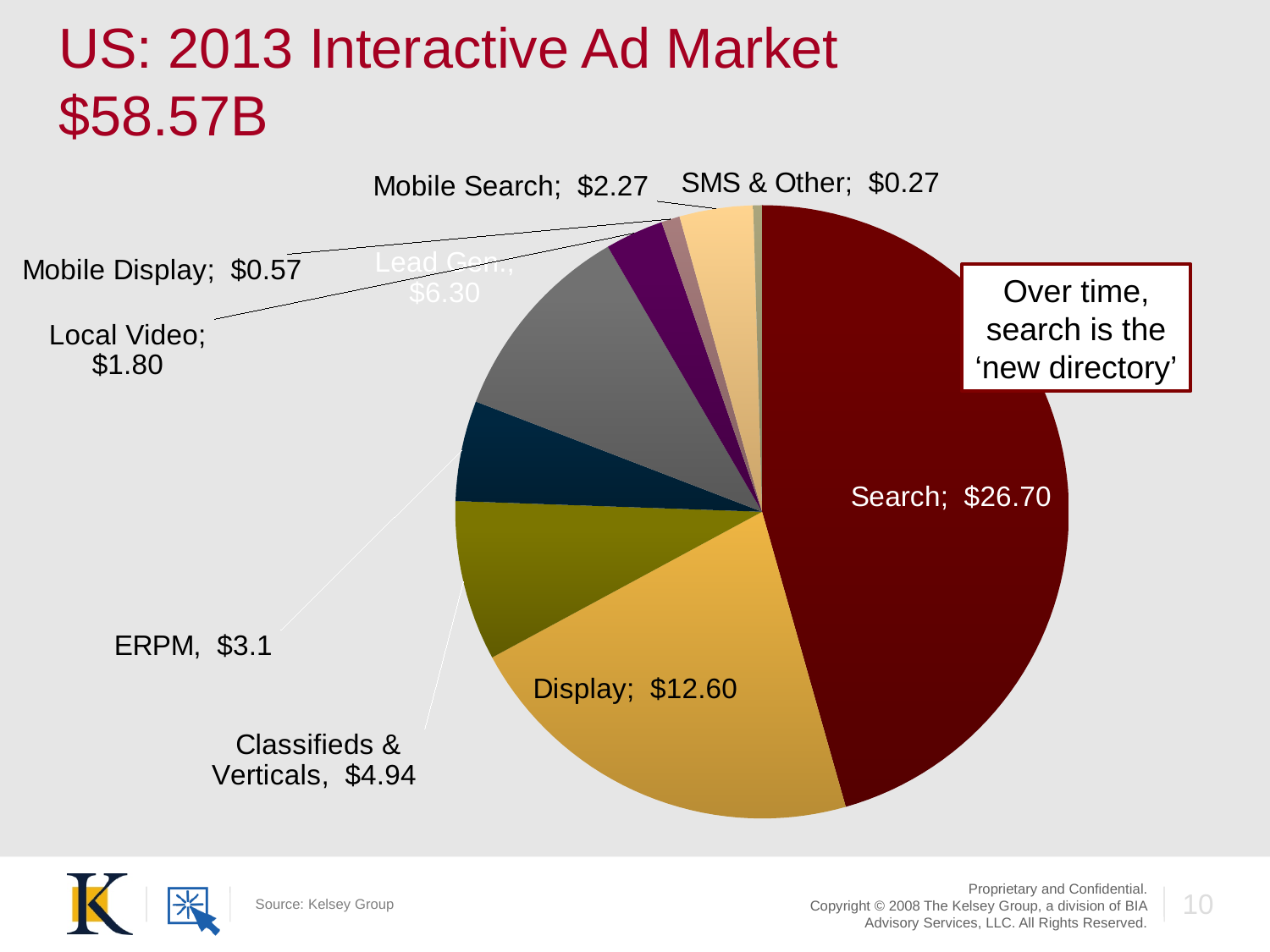
Which category has the largest slice of the pie? Search What is the value for Display in the pie chart? $12.60 What is the value for SMS & Other? $0.27 What total market size is given in the slide title? $58.57B What is the value for Search in the pie chart? $26.70 Which is larger, Local Video or Mobile Display? Local Video Which category has the smallest slice of the pie? SMS & Other How many slices does the pie chart have? 9 What is the value for Mobile Search? $2.27 What is the difference between the Search and Display values? $14.10 What type of chart is shown on the slide? Pie chart What is the value for Classifieds & Verticals? $4.94